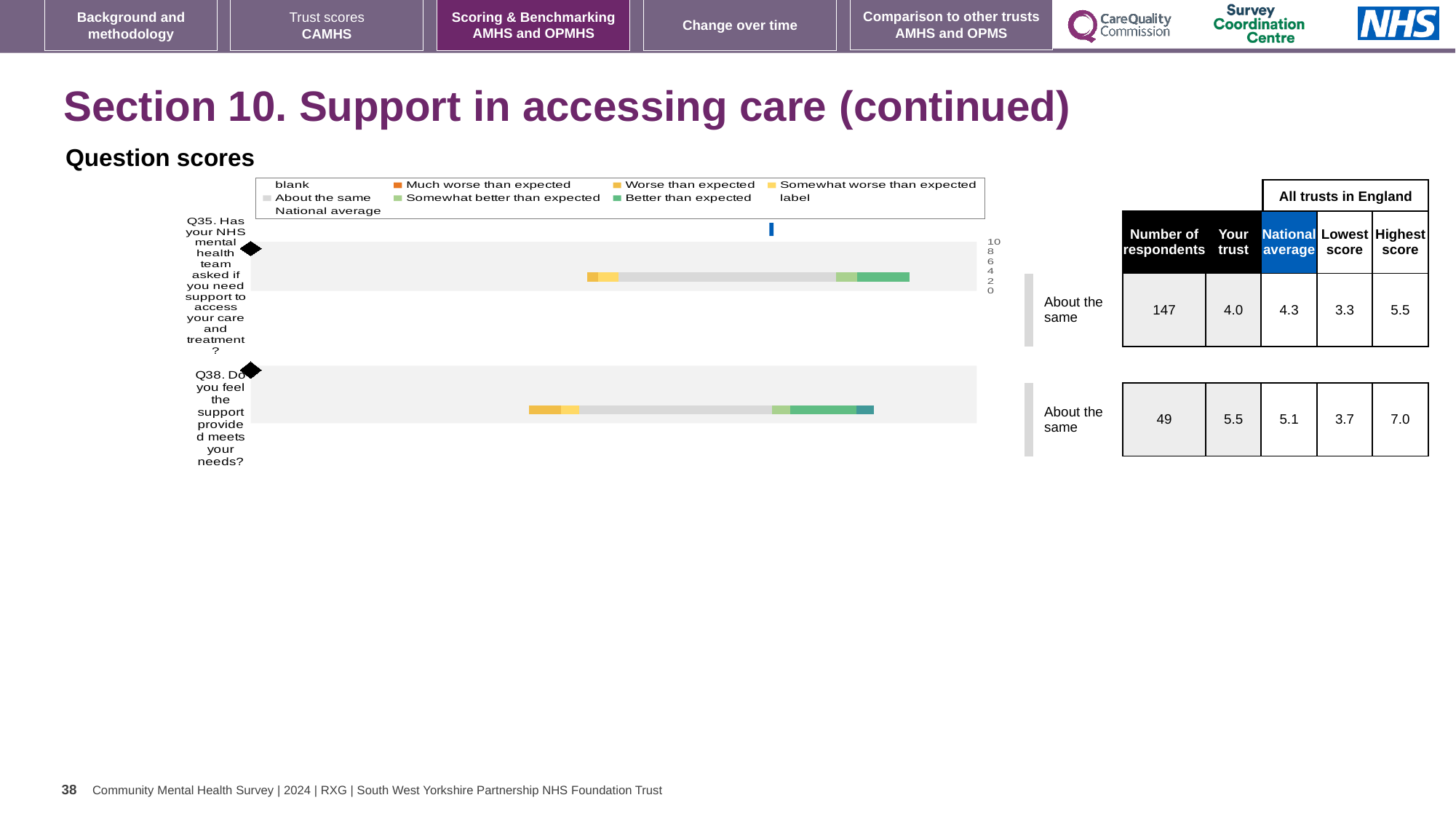
What is the difference between the highest score and the lowest score for Q38? 3.3 Which legend entry is shown in light grey? About the same What benchmark category is shown next to the Q35 bar? About the same For Q38, which is larger: the 'Your trust' score or the national average? Your trust What is the highest score across all trusts in England for Q35? 5.5 Which question has more respondents, Q35 or Q38? Q35 How many questions (bars) are plotted in the chart? 2 In the table beside the chart, what is the national average for Q38? 5.1 How many respondents are listed for Q38? 49 How many respondents are listed for Q35? 147 In the table beside the chart, what is the 'Your trust' score for Q35? 4.0 What kind of chart is shown under 'Question scores'? bar chart